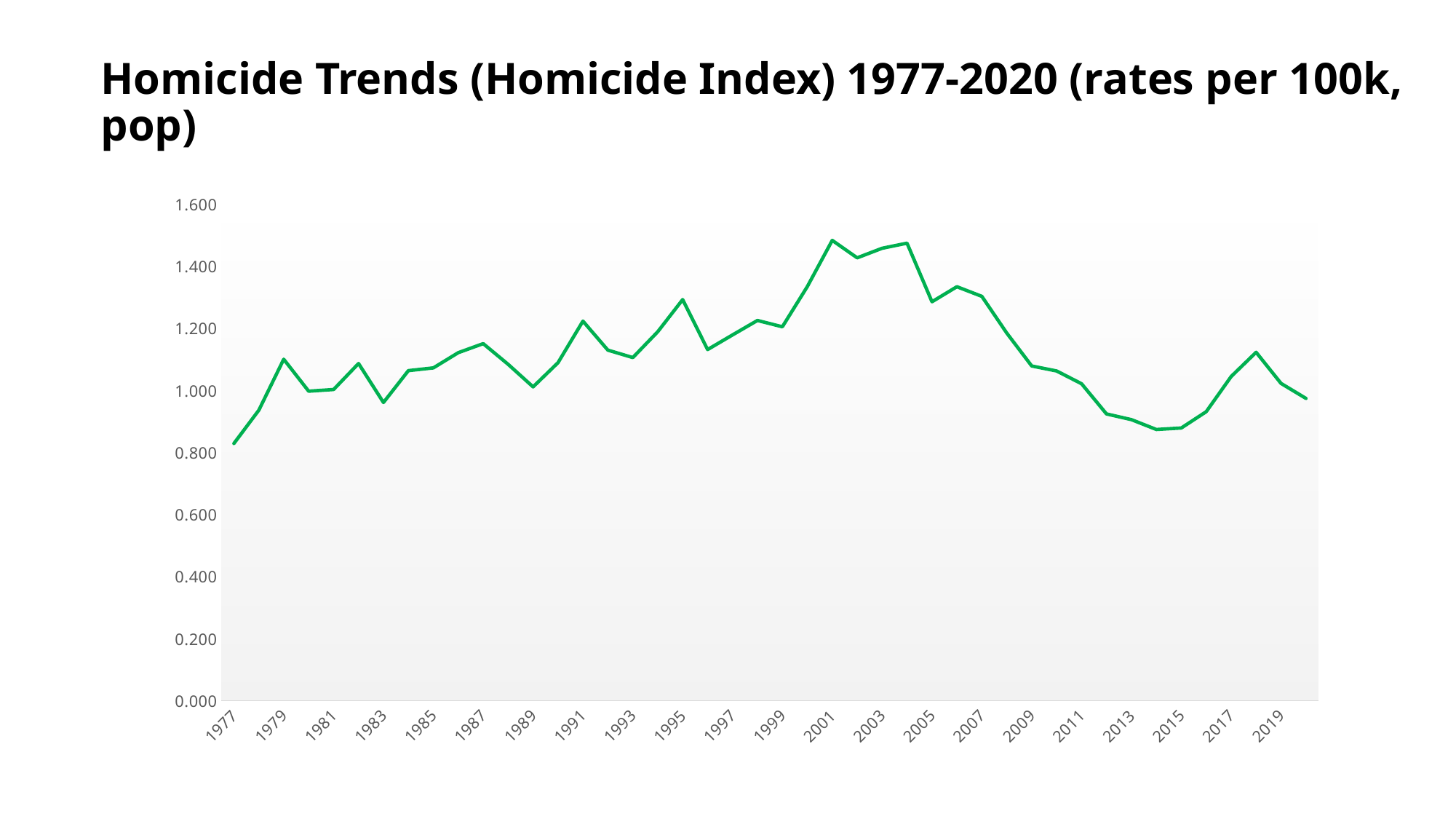
Is the value for 2013 greater or less than 1.000? less Is the value for 1995 greater or less than 1.200? greater Do the values rise or fall between 2005 and 2013? fall What colour is the line in the chart? green What kind of chart is shown on the slide? line chart Is the value for 2001 greater or less than 1.400? greater Which year has the higher value, 2007 or 2013? 2007 What is the title of the chart? Homicide Trends (Homicide Index) 1977-2020 (rates per 100k, pop) Which year has the higher value, 2001 or 1977? 2001